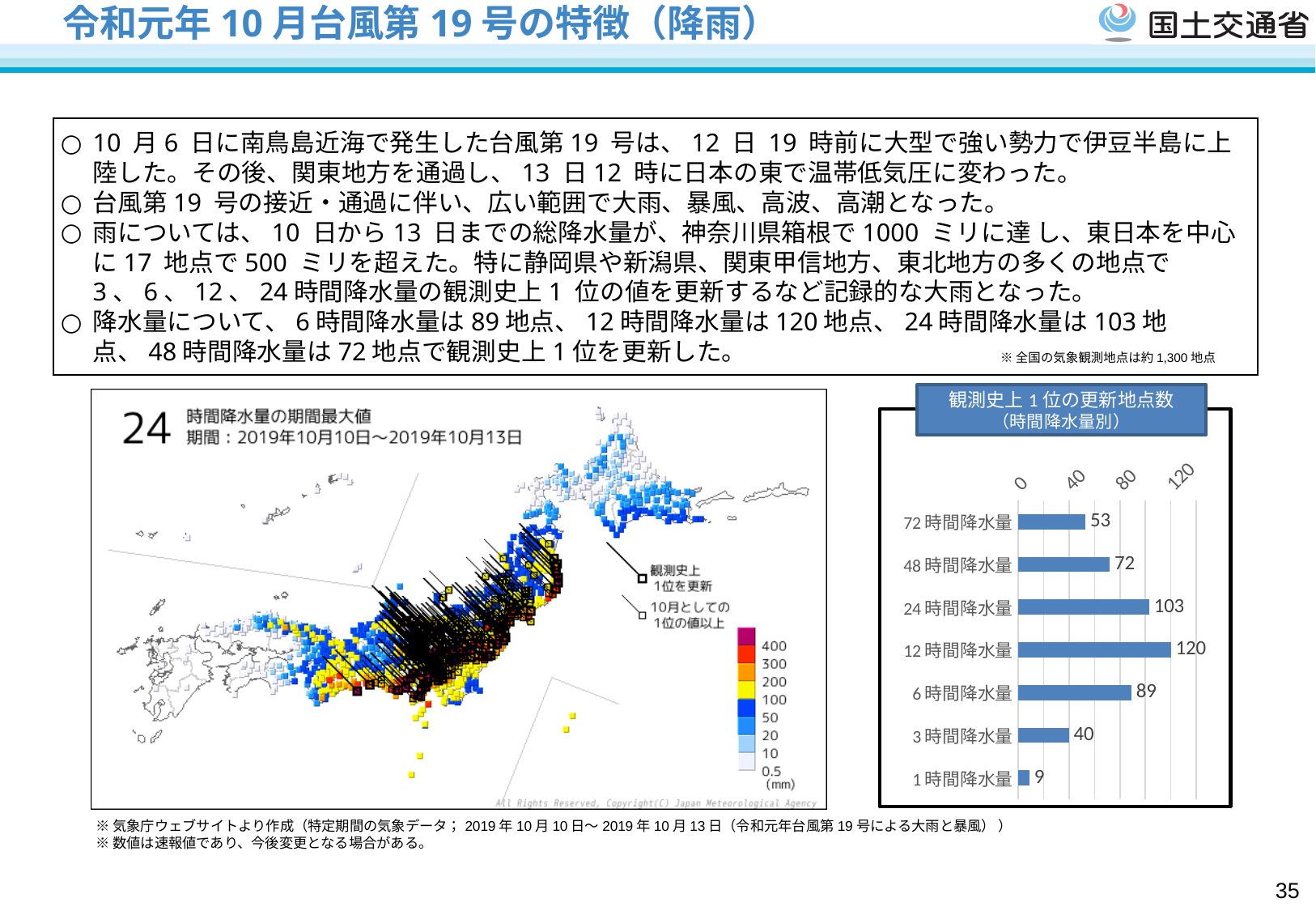
What kind of chart is the chart titled 観測史上1位の更新地点数（時間降水量別）? bar chart In the bar chart titled 観測史上1位の更新地点数（時間降水量別）, which category has the lowest value? 1時間降水量 In the bar chart titled 観測史上1位の更新地点数（時間降水量別）, which is larger, the value for 6時間降水量 or the value for 48時間降水量? 6時間降水量 In the bar chart titled 観測史上1位の更新地点数（時間降水量別）, what is the difference between the values for 24時間降水量 and 72時間降水量? 50 In the bar chart titled 観測史上1位の更新地点数（時間降水量別）, is the value for 24時間降水量 greater or less than 80? greater In the bar chart titled 観測史上1位の更新地点数（時間降水量別）, what is the difference between the values for 12時間降水量 and 6時間降水量? 31 In the bar chart titled 観測史上1位の更新地点数（時間降水量別）, what is the value for 48時間降水量? 72 In the bar chart titled 観測史上1位の更新地点数（時間降水量別）, what is the value for 1時間降水量? 9 What is the title of the chart on the right side of the slide? 観測史上1位の更新地点数（時間降水量別） In the bar chart titled 観測史上1位の更新地点数（時間降水量別）, what is the value for 12時間降水量? 120 In the bar chart titled 観測史上1位の更新地点数（時間降水量別）, which category has the highest value? 12時間降水量 How many categories are shown in the bar chart titled 観測史上1位の更新地点数（時間降水量別）? 7